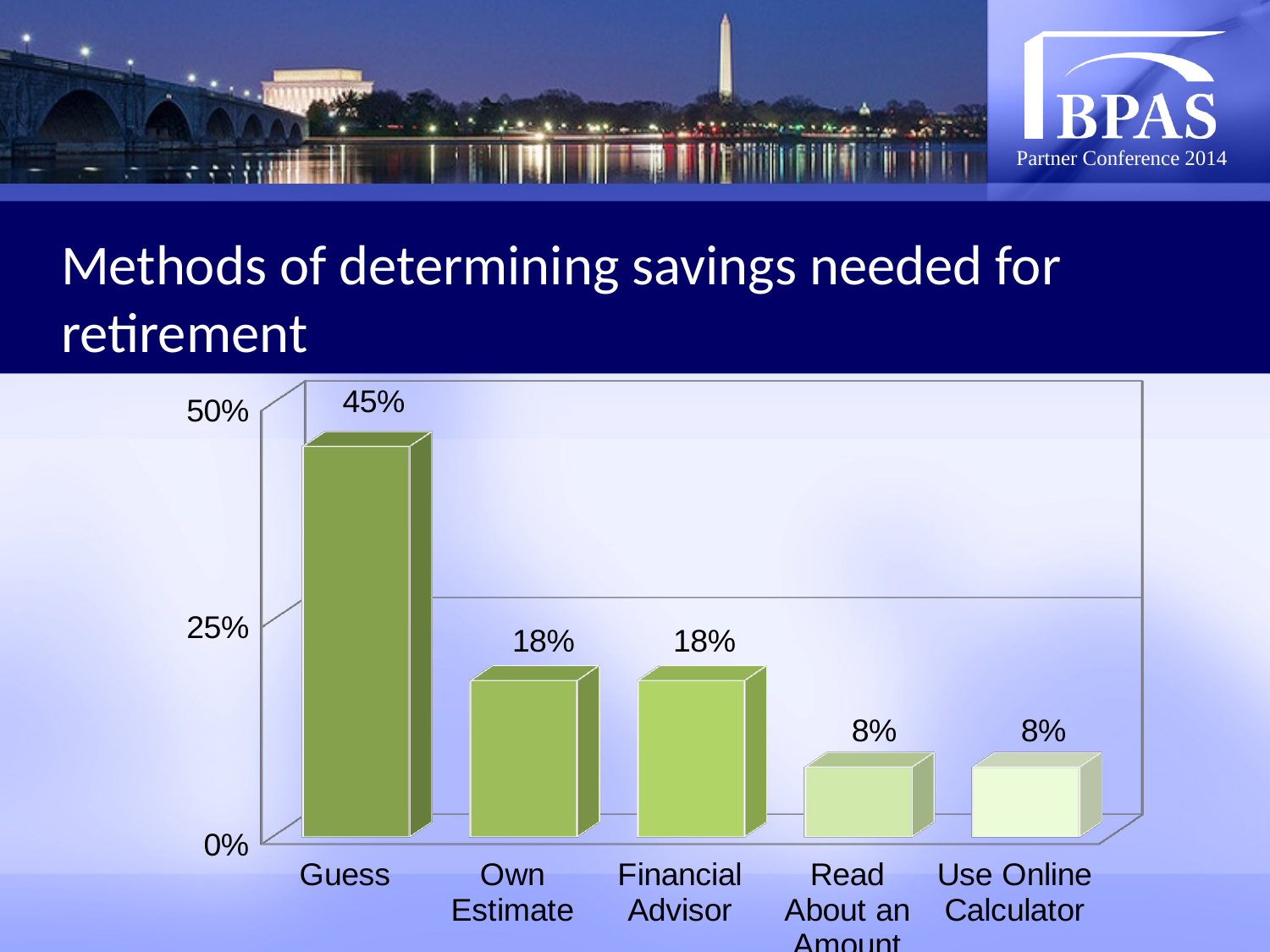
What is the title of the slide? Methods of determining savings needed for retirement Which is larger, the value for 'Financial Advisor' or the value for 'Use Online Calculator'? Financial Advisor Is the value for 'Own Estimate' greater or less than 25%? less Is the value for 'Guess' greater or less than 25%? greater Which method has the highest value? Guess What is the difference between the values for 'Guess' and 'Financial Advisor'? 27% What percentage of respondents use 'Guess' as their method of determining savings needed for retirement? 45% What is the difference between the values for 'Own Estimate' and 'Read About an Amount'? 10% What is the value for 'Use Online Calculator'? 8% What is the value for 'Own Estimate'? 18% How many methods (categories) are shown in the chart? 5 What kind of chart is shown on the slide? Bar chart